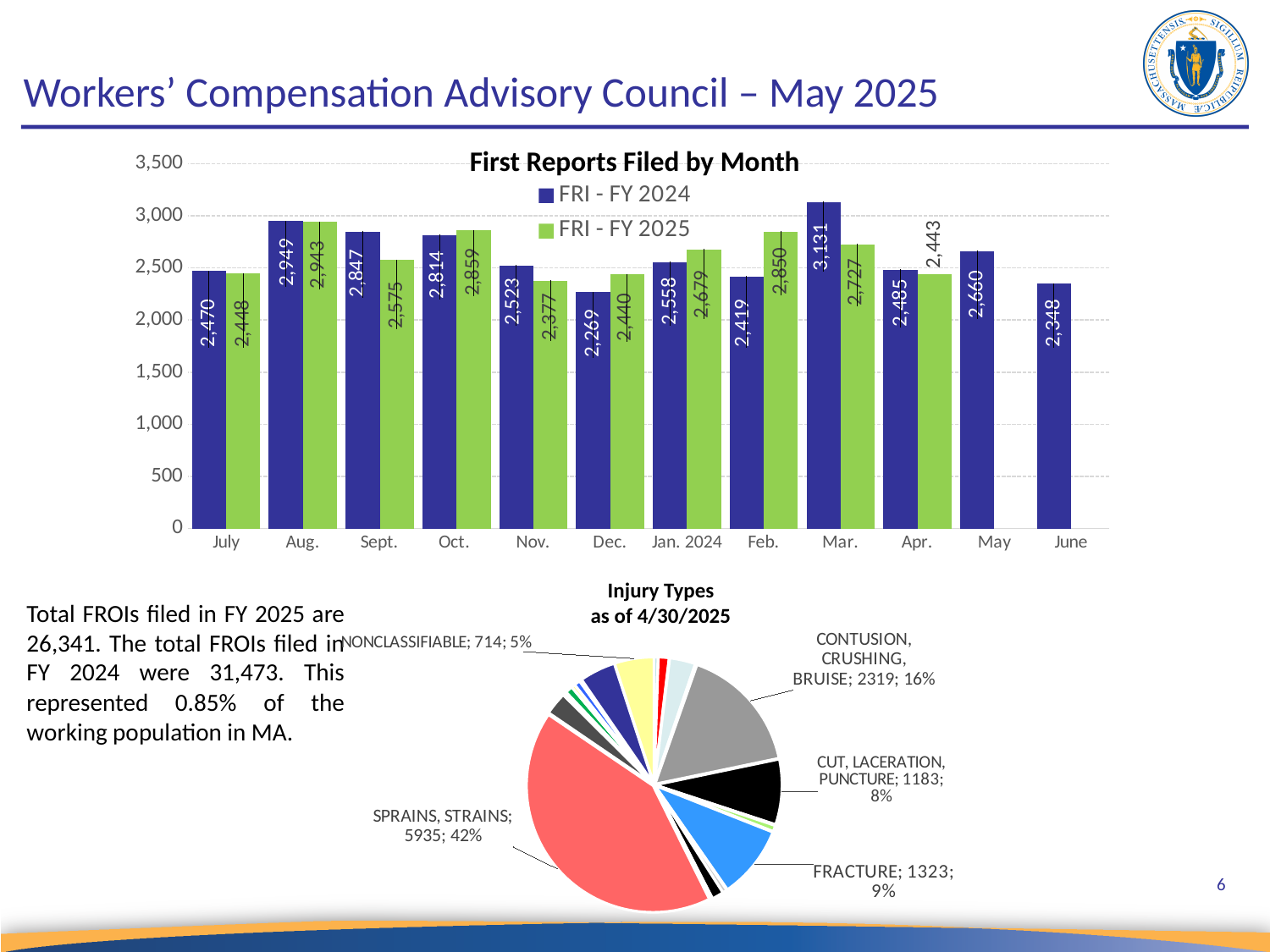
In the 'First Reports Filed by Month' chart, what is the difference between the FRI - FY 2024 and FRI - FY 2025 values for September? 272 In the 'First Reports Filed by Month' chart, which is larger for February: FRI - FY 2024 or FRI - FY 2025? FRI - FY 2025 In the 'First Reports Filed by Month' chart, what is the FRI - FY 2025 value for October? 2,859 In the 'First Reports Filed by Month' chart, which month has the lowest FRI - FY 2024 value? Dec. In the 'Injury Types as of 4/30/2025' pie chart, what is the count for FRACTURE? 1323 In the 'Injury Types as of 4/30/2025' pie chart, what share of injuries are SPRAINS, STRAINS? 42% In the 'First Reports Filed by Month' chart, what is the FRI - FY 2024 value for March? 3,131 In the 'First Reports Filed by Month' chart, how many months are shown on the x axis? 12 In the 'First Reports Filed by Month' chart, how many series does the legend list? 2 In the 'Injury Types as of 4/30/2025' pie chart, which is larger: CONTUSION, CRUSHING, BRUISE or CUT, LACERATION, PUNCTURE? CONTUSION, CRUSHING, BRUISE What kind of chart is 'First Reports Filed by Month'? Bar chart In the 'First Reports Filed by Month' chart, which month has the highest FRI - FY 2024 value? Mar.